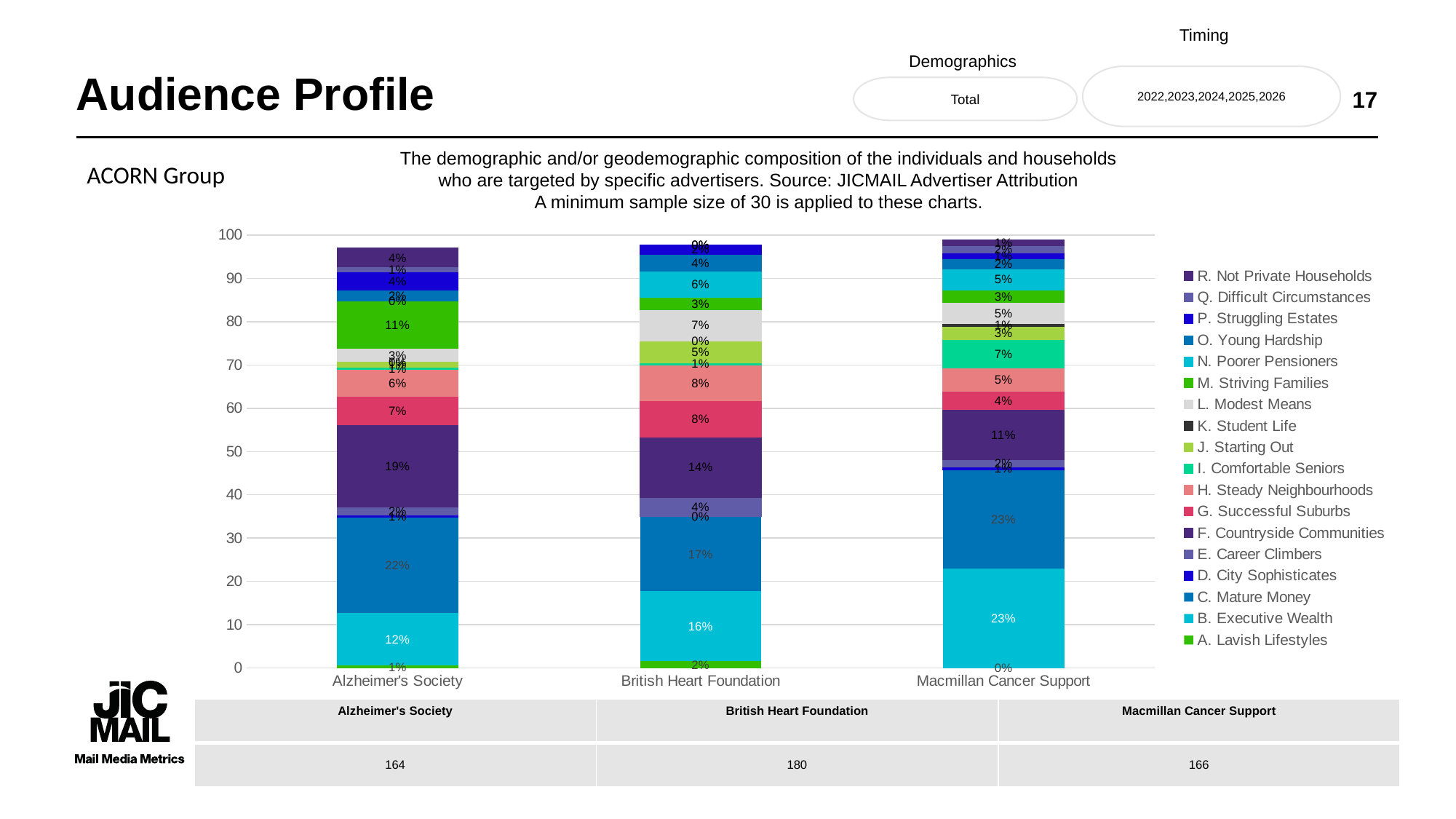
Which advertiser has the highest value for B. Executive Wealth? Macmillan Cancer Support What is the value for L. Modest Means for British Heart Foundation? 7% How many advertisers (categories) are shown on the x axis of the chart? 3 What is the value for B. Executive Wealth for British Heart Foundation? 16% What is the value for I. Comfortable Seniors for Macmillan Cancer Support? 7% What is the value for F. Countryside Communities for Macmillan Cancer Support? 11% How many series does the chart's legend list? 18 Which has the larger value for F. Countryside Communities, Alzheimer's Society or British Heart Foundation? Alzheimer's Society What is the value for C. Mature Money for Alzheimer's Society? 22% What is the difference between the B. Executive Wealth values for Macmillan Cancer Support and Alzheimer's Society? 11 percentage points What kind of chart is shown on the slide? Stacked bar chart What is the value for M. Striving Families for Alzheimer's Society? 11%